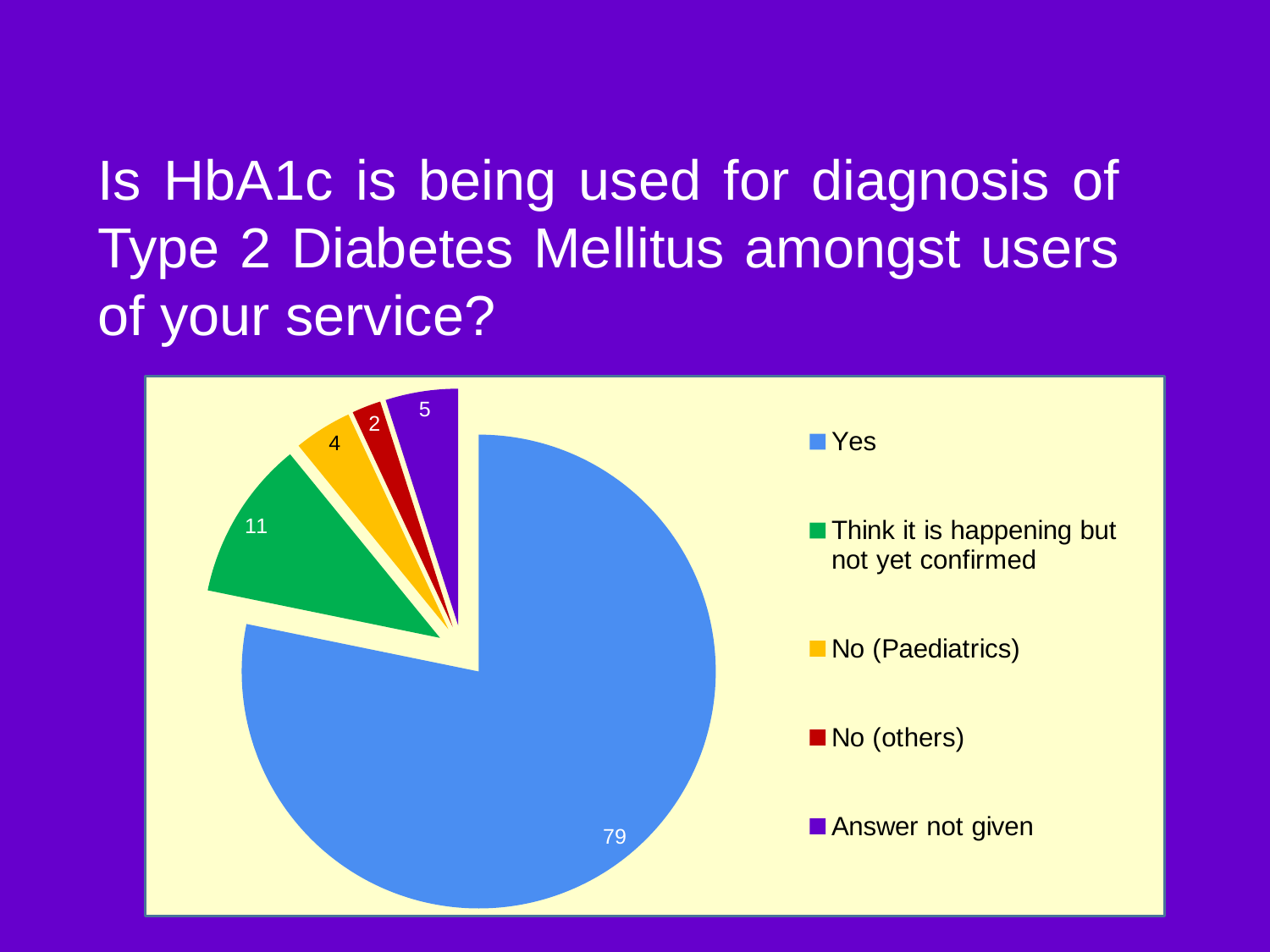
What is the value for 'Think it is happening but not yet confirmed'? 11 What colour is the 'Think it is happening but not yet confirmed' slice? Green What is the difference between the 'Yes' value and the 'Think it is happening but not yet confirmed' value? 68 Which category has the largest slice of the pie? Yes What type of chart is shown on the slide? Pie chart What is the value for 'Answer not given'? 5 What is the value for 'No (others)'? 2 Which is larger, 'Answer not given' or 'No (Paediatrics)'? Answer not given What is the value for the 'Yes' slice? 79 What is the value for 'No (Paediatrics)'? 4 How many categories does the pie chart have? 5 Which category has the smallest slice of the pie? No (others)